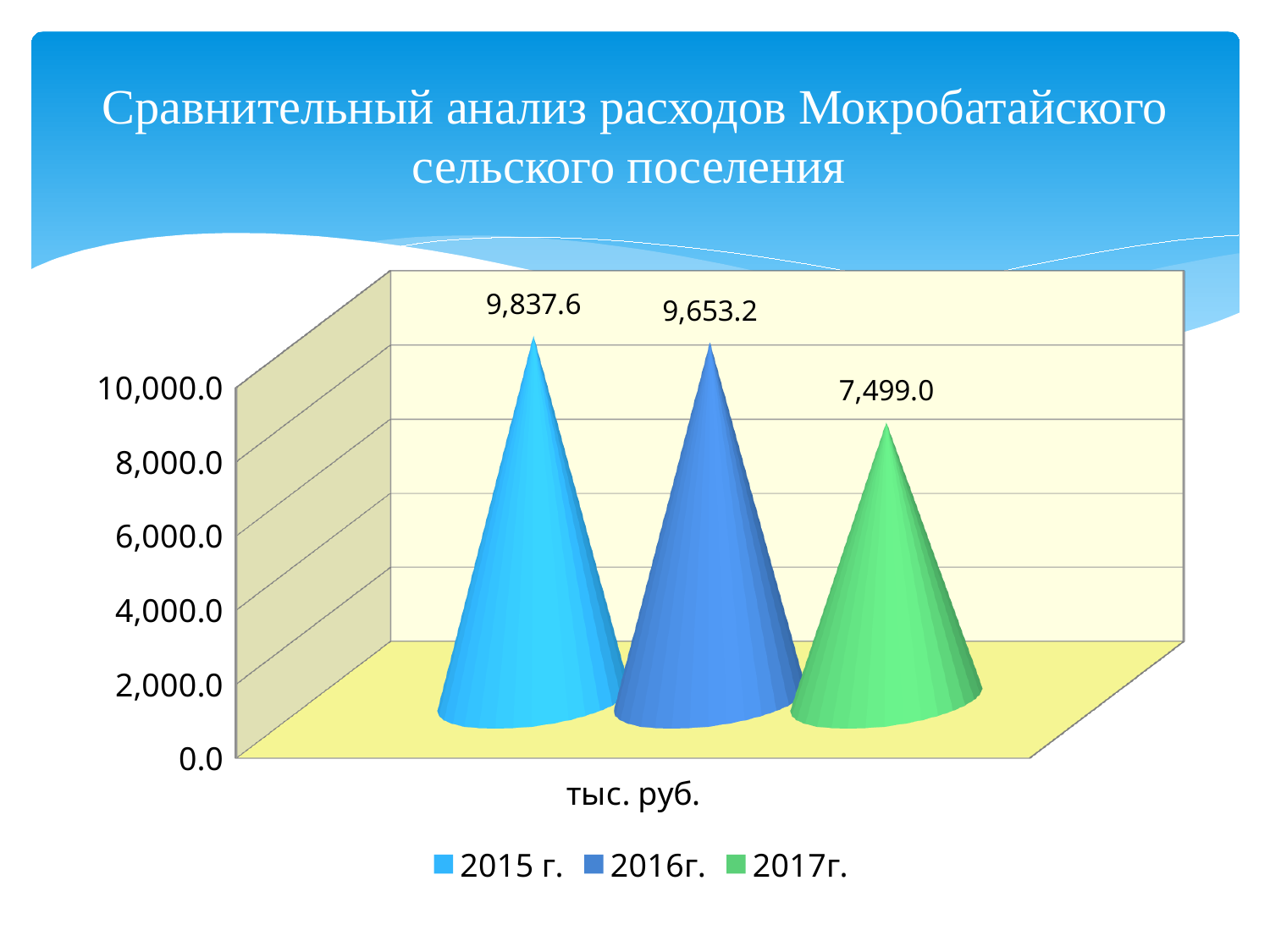
Which year has the highest value? 2015 г. Which year has the lowest value? 2017г. Is the value for 2017г. greater or less than 8,000.0? less What is the difference between the values for 2015 г. and 2016г.? 184.4 What is the value for 2015 г.? 9,837.6 Do the values rise or fall from 2015 г. to 2017г.? fall What is the difference between the values for 2015 г. and 2017г.? 2,338.6 Which is larger, the value for 2016г. or the value for 2017г.? 2016г. What unit is shown on the category axis label? тыс. руб. What is the value for 2017г.? 7,499.0 How many series does the legend list? 3 What is the value for 2016г.? 9,653.2